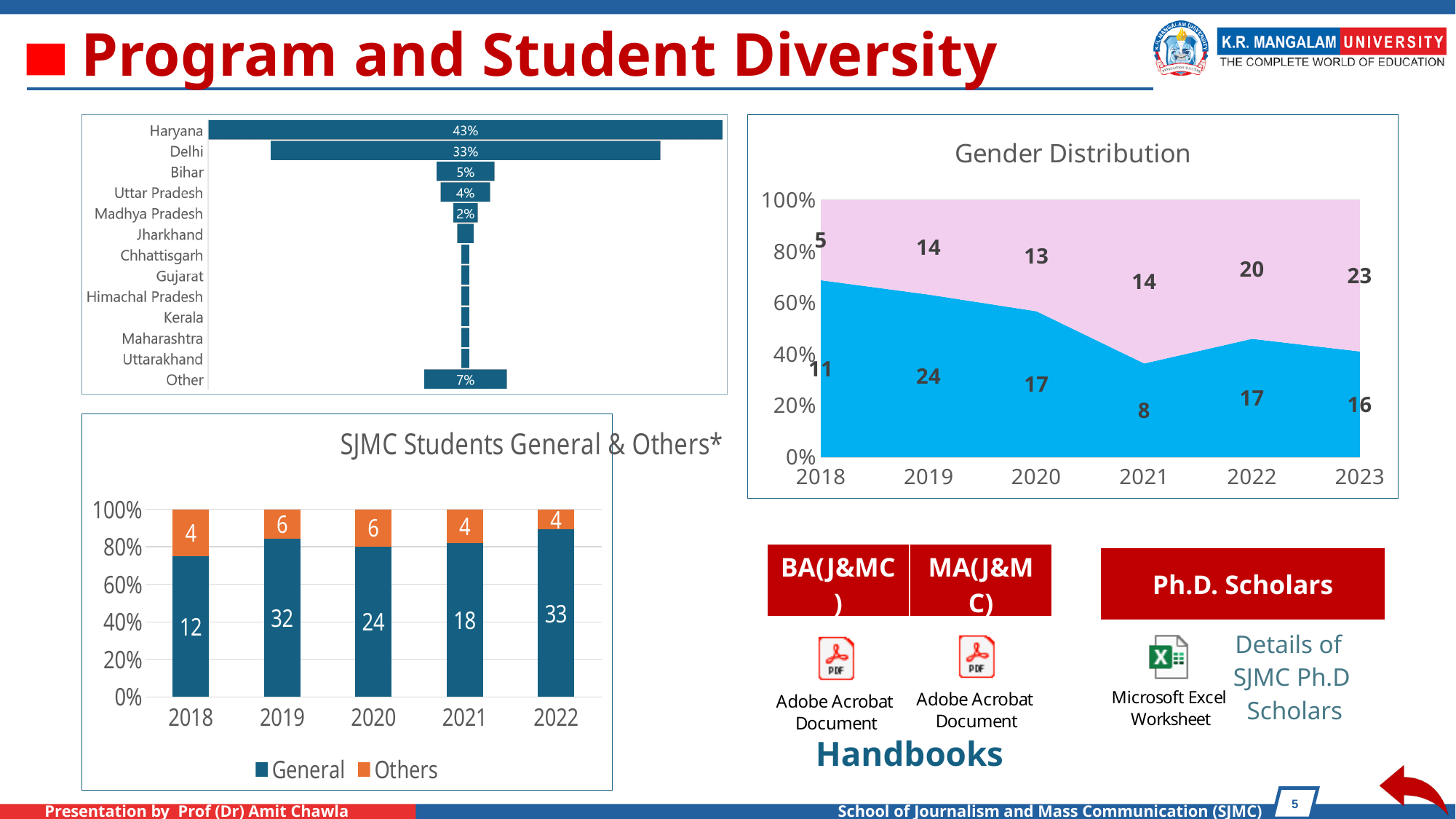
In the top-left bar chart of states, which state has the highest value? Haryana In the 'SJMC Students General & Others*' chart, how many series does the legend list? 2 In the top-left bar chart of states, what is the difference between the values for Haryana and Delhi? 10% What kind of chart is the 'Gender Distribution' chart? Stacked area chart In the 'SJMC Students General & Others*' chart, what is the General value for 2019? 32 In the top-left bar chart of states, what is the value for Haryana? 43% In the 'SJMC Students General & Others*' chart, which year has the lowest General value? 2018 In the 'Gender Distribution' chart, what is the value labelled in the upper (pink) area for 2023? 23 In the top-left bar chart of states, how many categories are listed on the axis? 13 In the 'SJMC Students General & Others*' chart, what is the Others value for 2020? 6 In the 'SJMC Students General & Others*' chart, what is the total of the stacked bar for 2022? 37 In the top-left bar chart of states, what is the value for Delhi? 33%